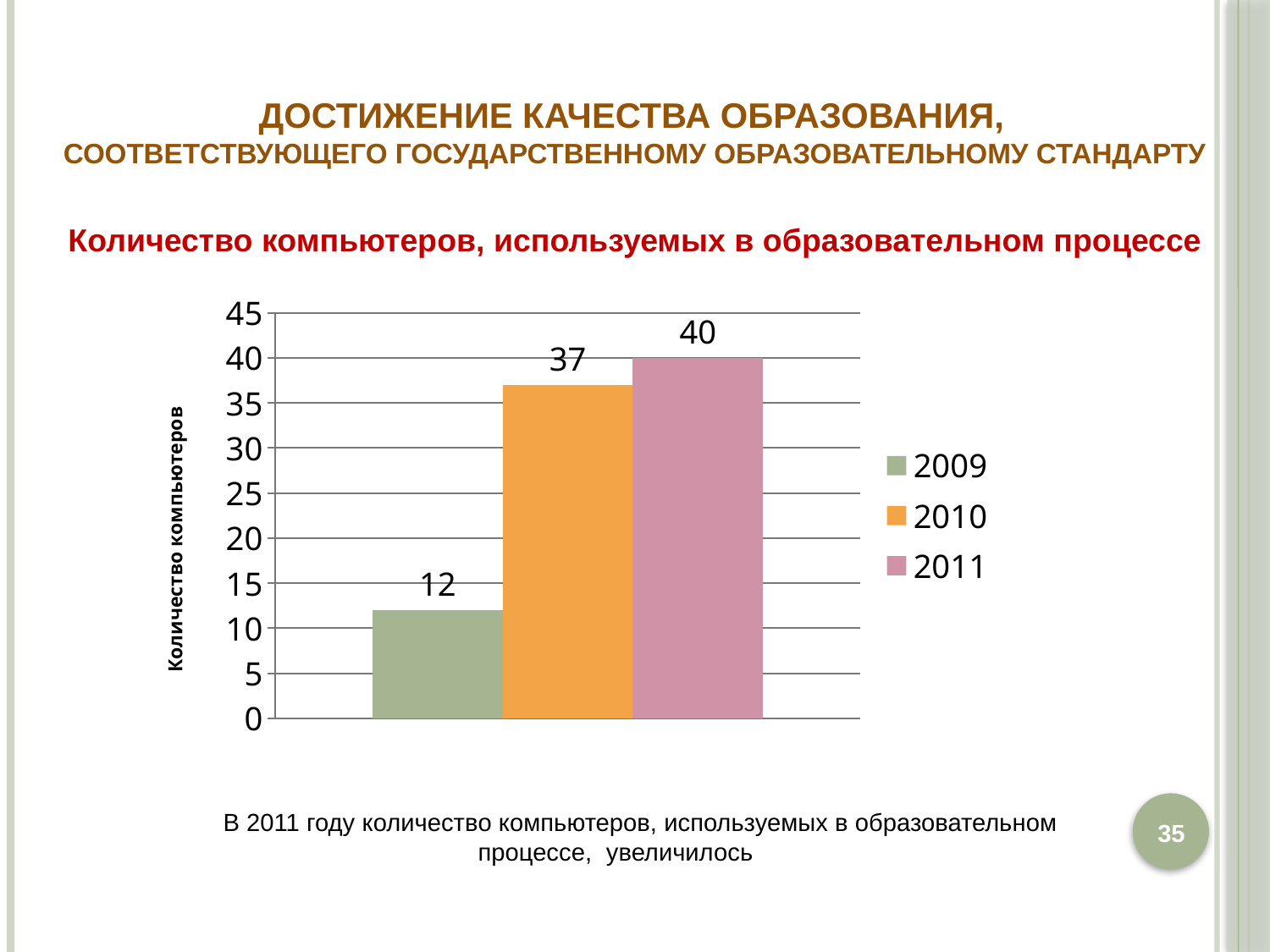
By how much did the number of computers increase from 2009 to 2010? 25 Which year has the highest number of computers? 2011 What kind of chart is shown on the slide? bar chart What is the difference between the values for 2011 and 2010? 3 Which year has the lowest number of computers? 2009 How many series does the legend list? 3 What is the value shown for 2010? 37 Do the values rise or fall from 2009 to 2011? rise Is the value for 2009 greater or less than 15? less How many computers were used in the educational process in 2009? 12 Which is larger, the value for 2009 or the value for 2010? 2010 What is the value shown for 2011? 40